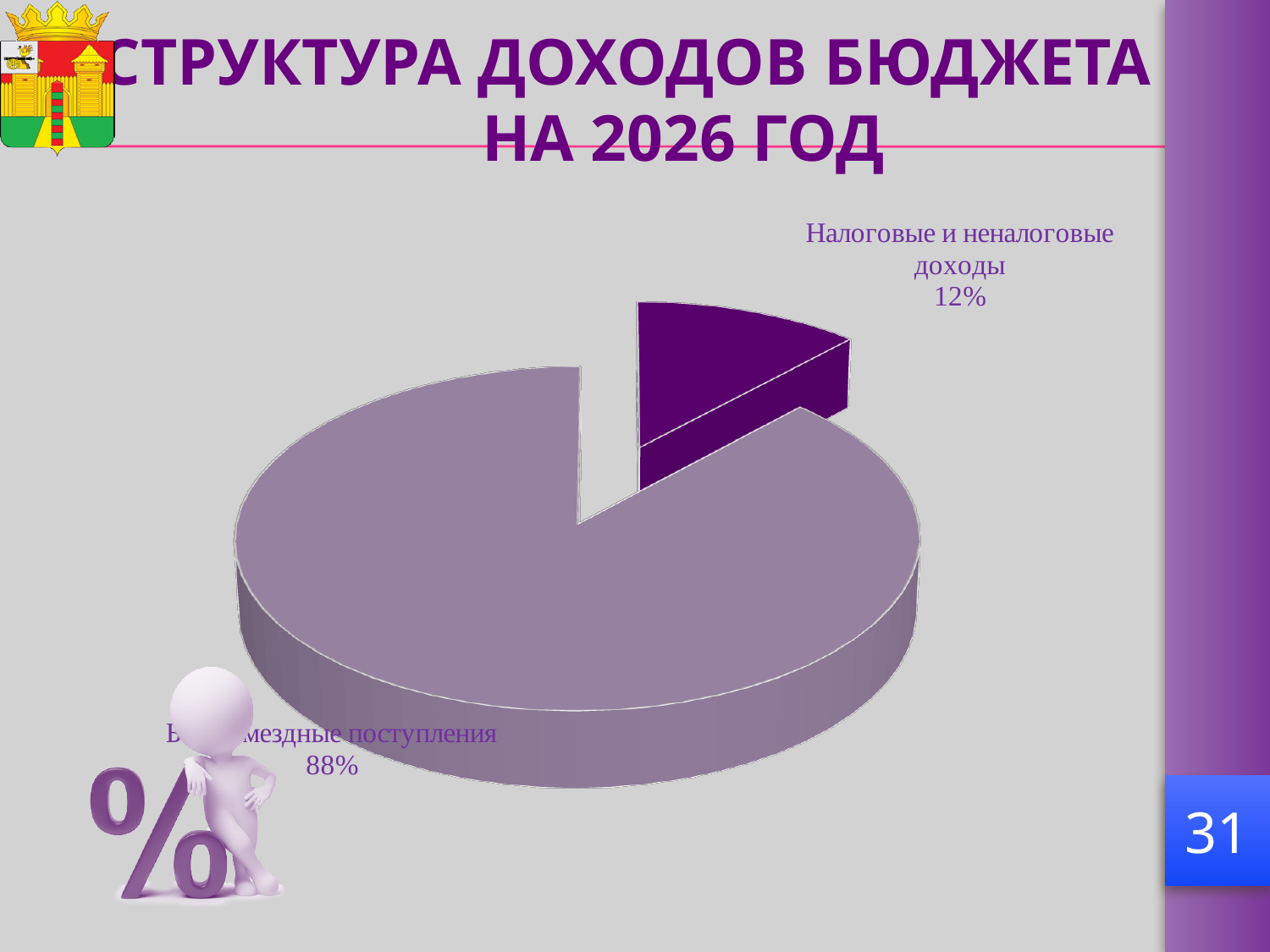
What colour is the slice for "Налоговые и неналоговые доходы"? Dark purple Which is larger: the share of "Безвозмездные поступления" or the share of "Налоговые и неналоговые доходы"? Безвозмездные поступления What is the difference in percentage points between "Безвозмездные поступления" and "Налоговые и неналоговые доходы"? 76 percentage points What share of the pie does "Безвозмездные поступления" represent? 88% Which category has the smallest slice of the pie? Налоговые и неналоговые доходы How many slices does the pie chart have? 2 What share of the pie does "Налоговые и неналоговые доходы" represent? 12% Which category has the largest slice of the pie? Безвозмездные поступления What is the value shown for the slice labelled "Безвозмездные поступления"? 88% What is the value shown for the slice labelled "Налоговые и неналоговые доходы"? 12% What kind of chart is shown on the slide? Pie chart What is the title of the slide? СТРУКТУРА ДОХОДОВ БЮДЖЕТА НА 2026 ГОД